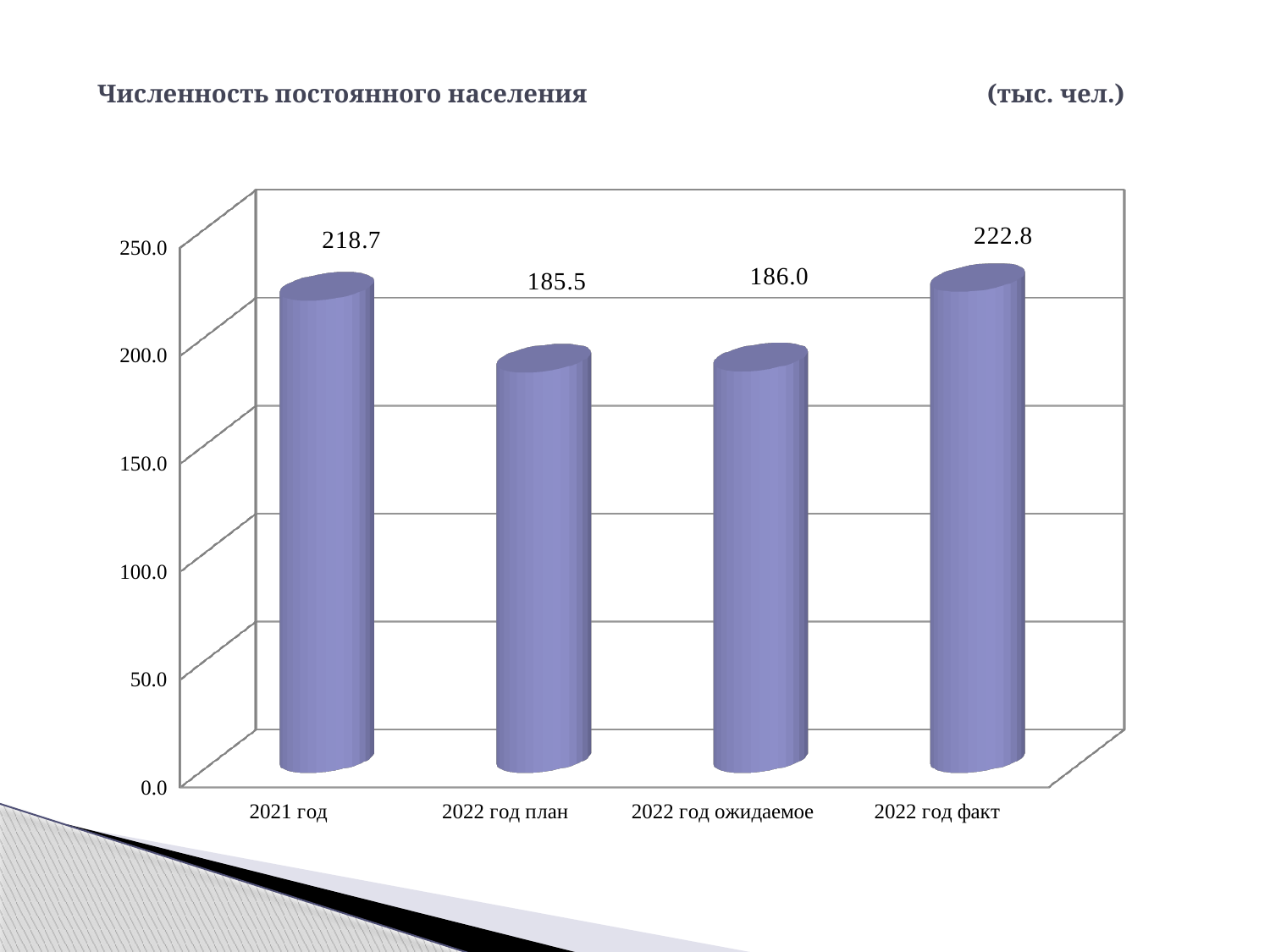
What is the value for 2022 год факт? 222.8 What is the value for 2022 год план? 185.5 Is the value for 2022 год план greater or less than 200.0? less What is the value for 2022 год ожидаемое? 186.0 What is the value for 2021 год? 218.7 What is the difference between the values for 2022 год факт and 2021 год? 4.1 What kind of chart is shown on the slide? bar chart Which is larger, the value for 2021 год or the value for 2022 год ожидаемое? 2021 год What is the difference between the values for 2021 год and 2022 год план? 33.2 Which category has the highest value? 2022 год факт How many categories are shown on the x axis? 4 Which category has the lowest value? 2022 год план